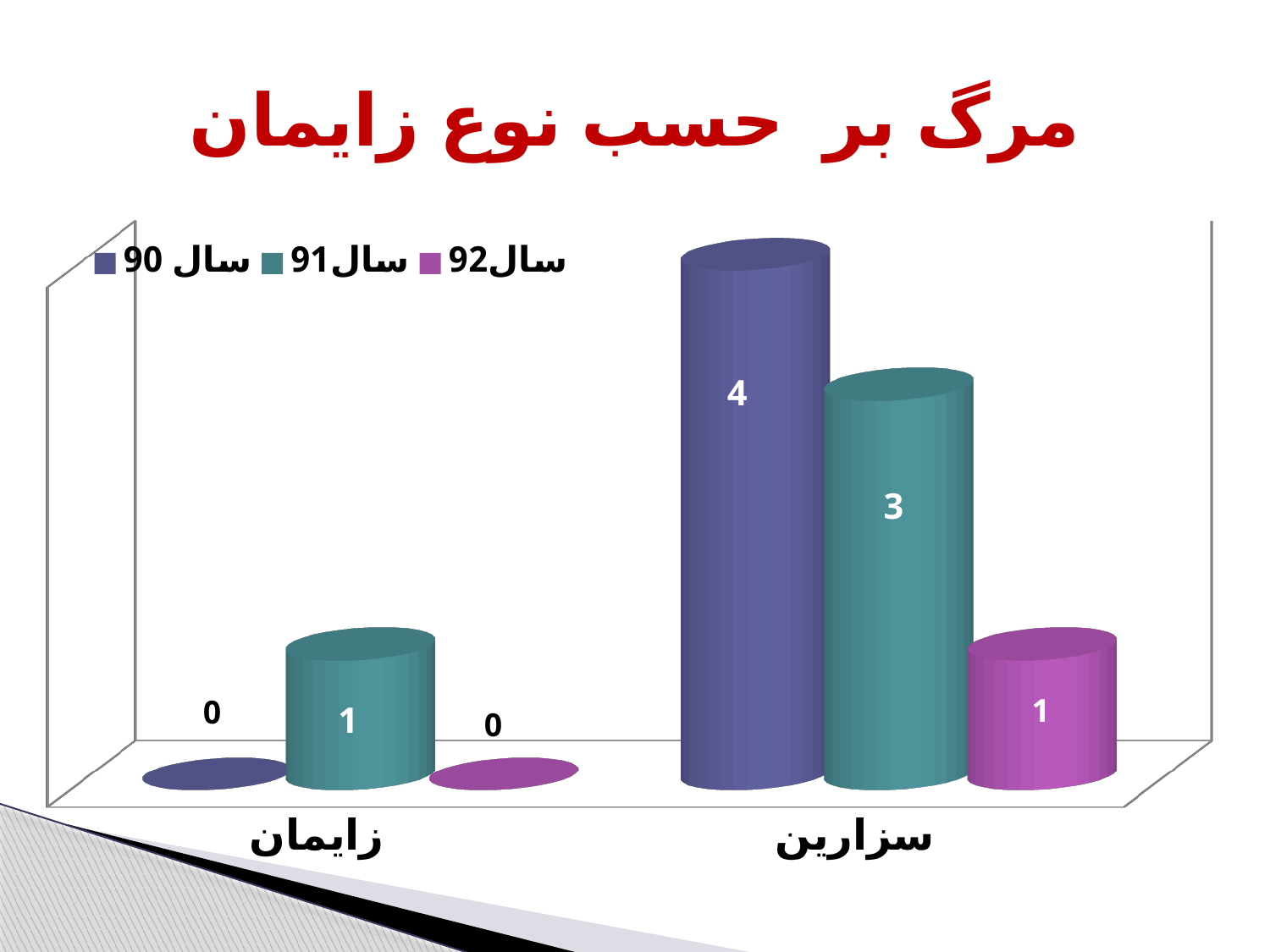
How many series does the legend list? 3 Which series has the lowest value for سزارین? سال92 Which is larger: the سال91 value for سزارین or the سال91 value for زایمان? سزارین Which category has the highest value in the سال 90 series? سزارین What is the value for سزارین in the سال 90 series? 4 What is the difference between the سال 90 and سال91 values for سزارین? 1 What is the value for زایمان in the سال 90 series? 0 What is the value for سزارین in the سال91 series? 3 What type of chart is shown on the slide? bar chart How many categories are shown on the x axis? 2 What is the value for زایمان in the سال91 series? 1 What is the value for سزارین in the سال92 series? 1